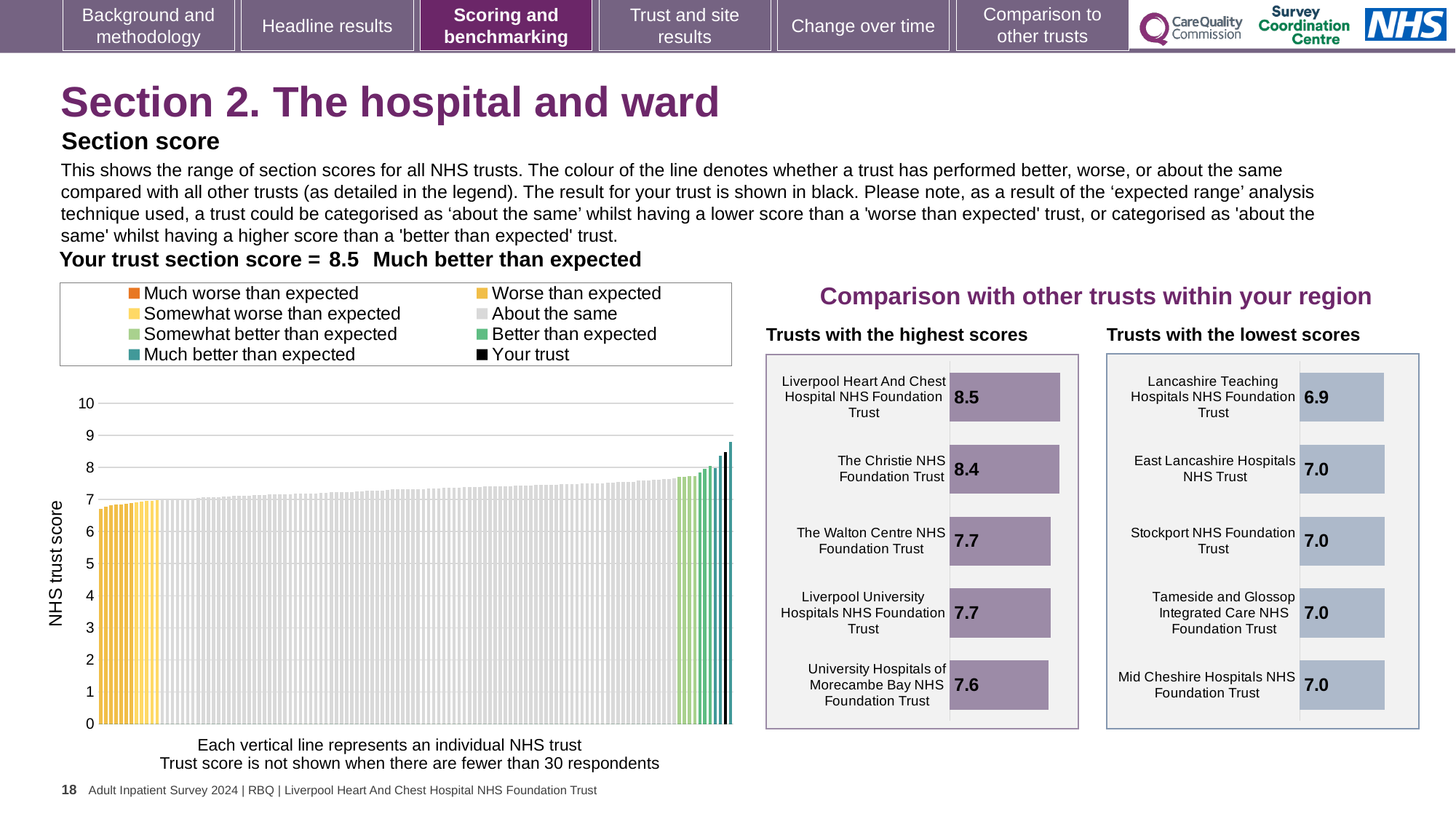
In the 'Trusts with the highest scores' chart, which trust has the highest score? Liverpool Heart And Chest Hospital NHS Foundation Trust How many trusts are shown in the 'Trusts with the highest scores' chart? 5 In the 'Trusts with the highest scores' chart, what is the difference between the scores of Liverpool Heart And Chest Hospital NHS Foundation Trust and University Hospitals of Morecambe Bay NHS Foundation Trust? 0.9 In the 'Trusts with the lowest scores' chart, what is the score for Lancashire Teaching Hospitals NHS Foundation Trust? 6.9 What is the y-axis label of the main chart on the left? NHS trust score In the 'Trusts with the lowest scores' chart, what is the score for Mid Cheshire Hospitals NHS Foundation Trust? 7.0 What kind of chart is the main chart showing the NHS trust scores for all trusts? Bar chart In the 'Trusts with the highest scores' chart, which has the larger score: The Walton Centre NHS Foundation Trust or The Christie NHS Foundation Trust? The Christie NHS Foundation Trust In the 'Trusts with the lowest scores' chart, which trust has the lowest score? Lancashire Teaching Hospitals NHS Foundation Trust How many entries does the legend of the main NHS trust score chart list? 8 In the 'Trusts with the highest scores' chart, what is the score for The Christie NHS Foundation Trust? 8.4 In the main NHS trust score chart, do the values rise or fall from left to right? Rise